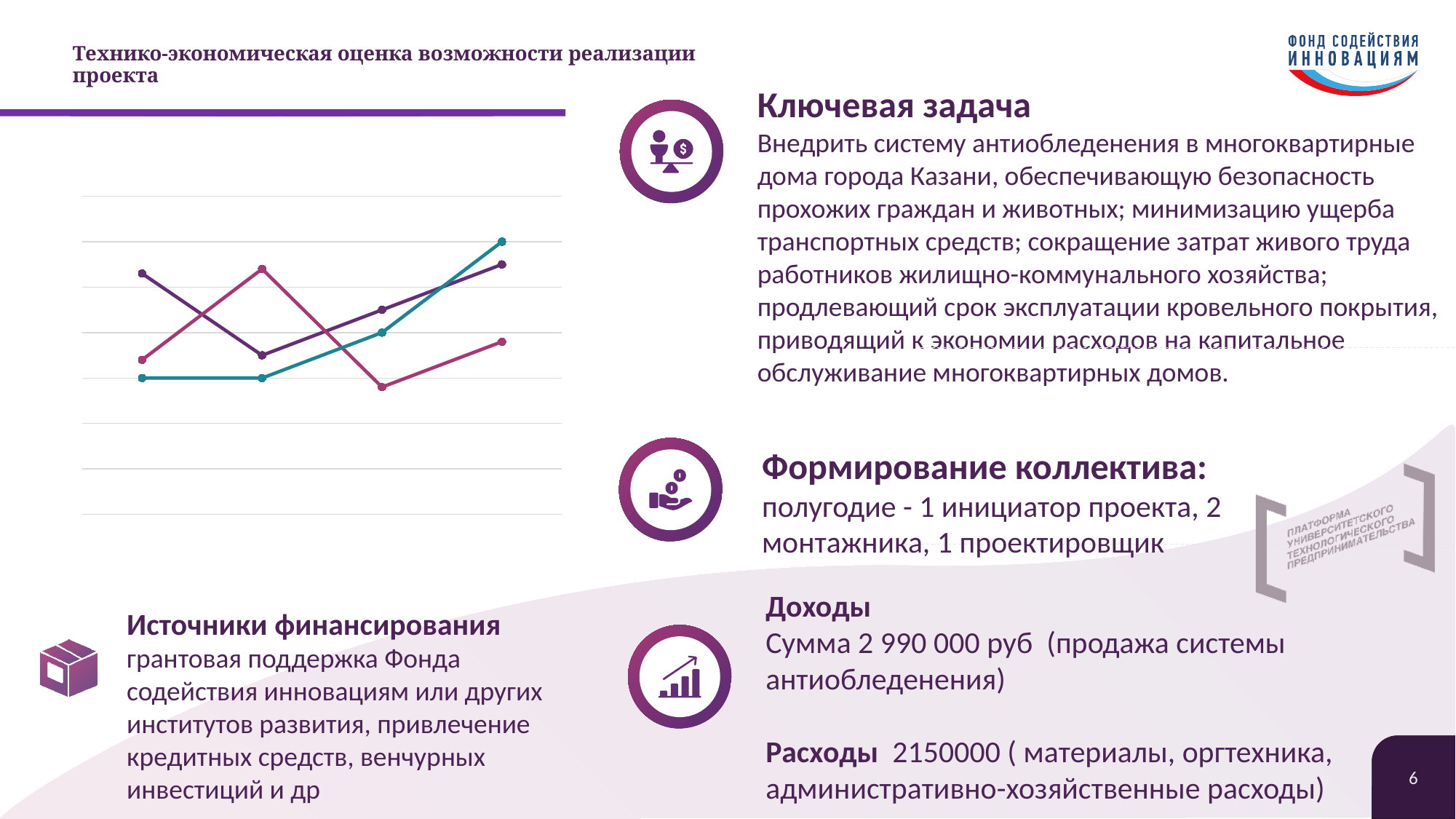
What kind of chart is shown on the left of the slide? line chart Does the teal line on the chart rise or fall from its first point to its last point? rises Which line reaches the highest point at the right end of the chart? the teal line How many data points does each line on the chart have? 4 How many lines are plotted on the chart? 3 Does the chart have a title? No Does the chart display a legend? No